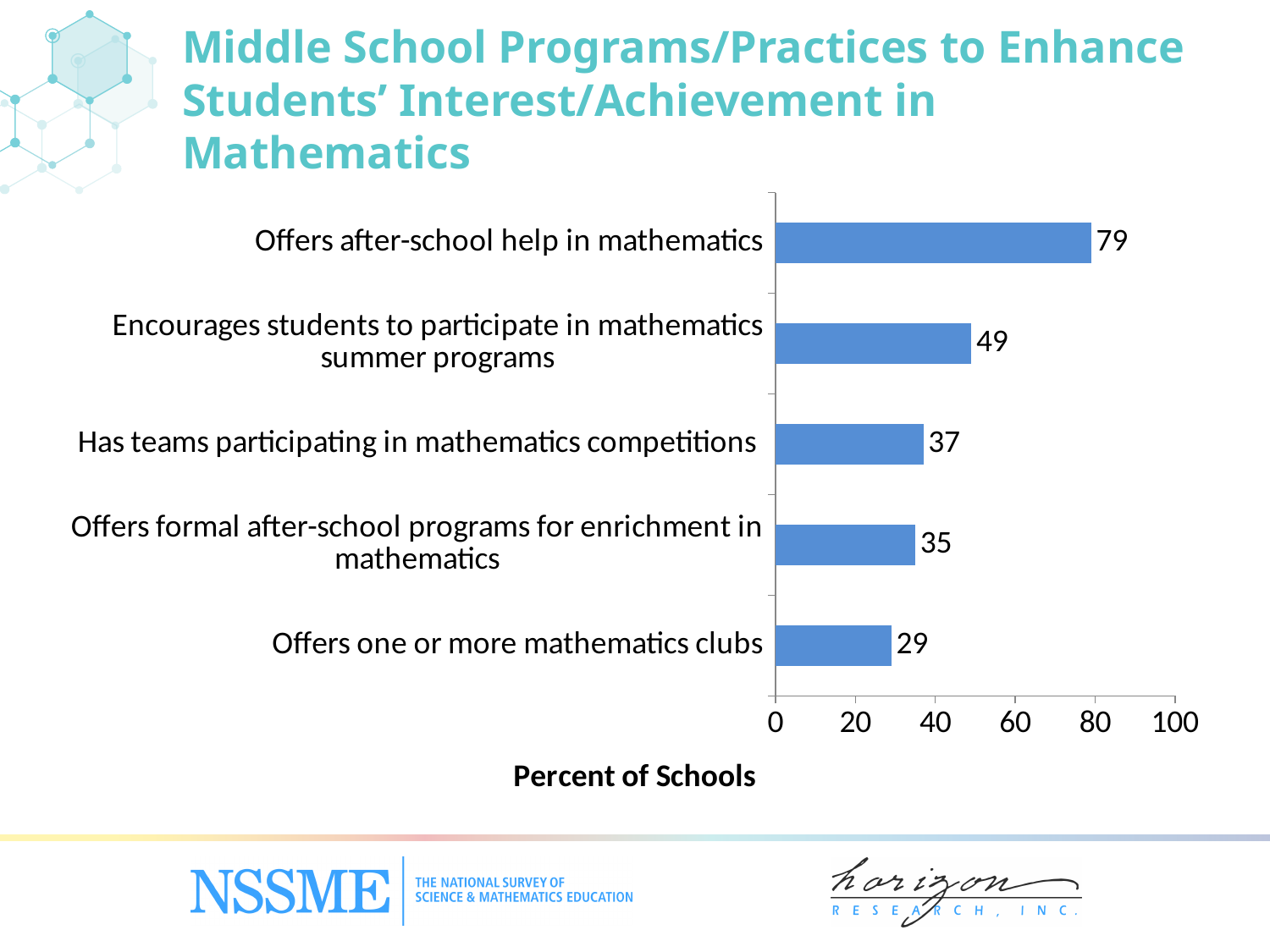
What is the difference between the values for 'Offers after-school help in mathematics' and 'Offers one or more mathematics clubs'? 50 Which is larger: the value for 'Has teams participating in mathematics competitions' or 'Offers formal after-school programs for enrichment in mathematics'? Has teams participating in mathematics competitions What is the value for 'Offers one or more mathematics clubs'? 29 Is the value for 'Encourages students to participate in mathematics summer programs' greater or less than 40? greater What percent of schools offer after-school help in mathematics? 79 Which program/practice has the lowest percent of schools? Offers one or more mathematics clubs What kind of chart is shown on the slide? Bar chart How many programs/practices are shown in the chart? 5 Which program/practice has the highest percent of schools? Offers after-school help in mathematics What is the value for 'Encourages students to participate in mathematics summer programs'? 49 What is the label of the horizontal axis? Percent of Schools What percent of schools have teams participating in mathematics competitions? 37